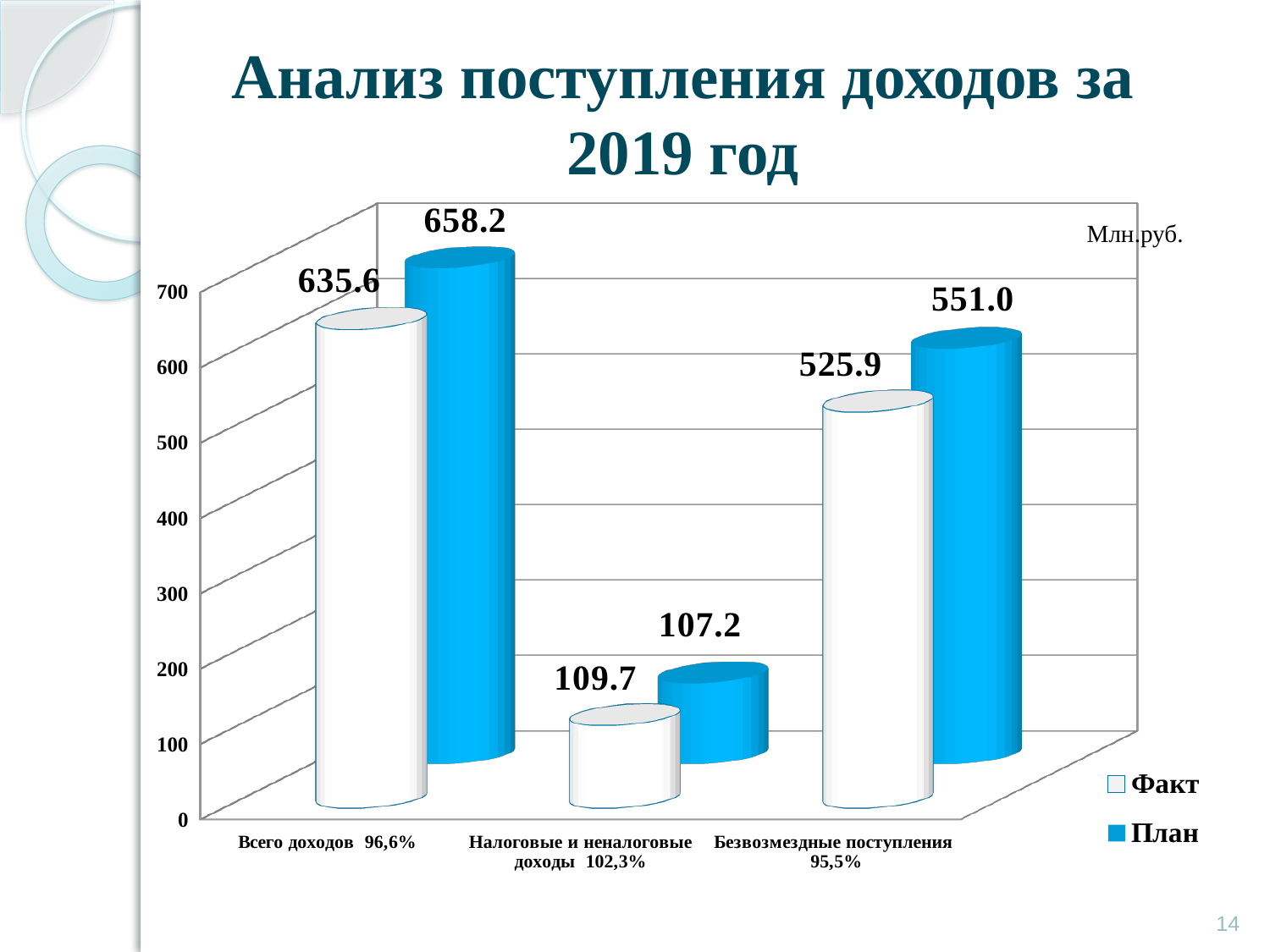
Which category has the highest Факт value? Всего доходов What is the Факт value for Всего доходов? 635.6 What is the План value for Всего доходов? 658.2 What is the Факт value for Налоговые и неналоговые доходы? 109.7 What kind of chart is shown on the slide? Bar chart Which is larger for Налоговые и неналоговые доходы, the Факт value or the План value? Факт How many categories are shown on the x axis? 3 Which category has the lowest План value? Налоговые и неналоговые доходы What is the difference between the План and Факт values for Безвозмездные поступления? 25.1 How many series does the legend list? 2 What is the План value for Безвозмездные поступления? 551.0 What is the difference between the План and Факт values for Всего доходов? 22.6